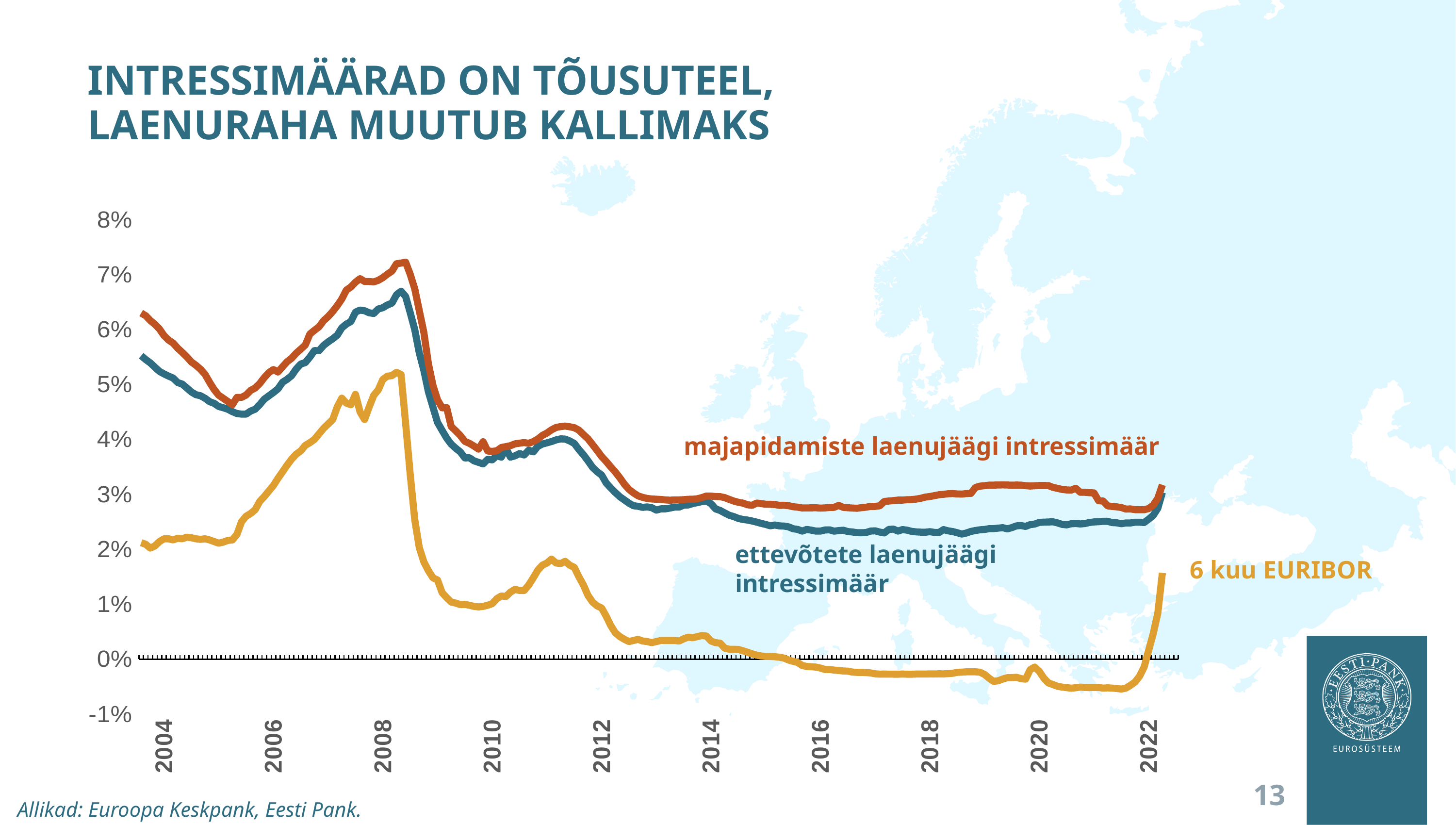
Does 6 kuu EURIBOR rise or fall at the very end of the series in 2022? rise Which series reaches the highest value on the chart? majapidamiste laenujäägi intressimäär Is the value of 6 kuu EURIBOR in 2012 greater or less than 1%? less Does 6 kuu EURIBOR rise or fall between 2008 and 2010? fall Is the value of 6 kuu EURIBOR in 2020 greater or less than 0%? less What kind of chart is shown on the slide? line chart How many series are plotted on the chart? 3 Which series has the lowest values across the whole period shown? 6 kuu EURIBOR In 2018, which is higher: majapidamiste laenujäägi intressimäär or ettevõtete laenujäägi intressimäär? majapidamiste laenujäägi intressimäär Is the value of ettevõtete laenujäägi intressimäär at its 2008 peak greater or less than 7%? less What sources are cited for the chart? Euroopa Keskpank, Eesti Pank